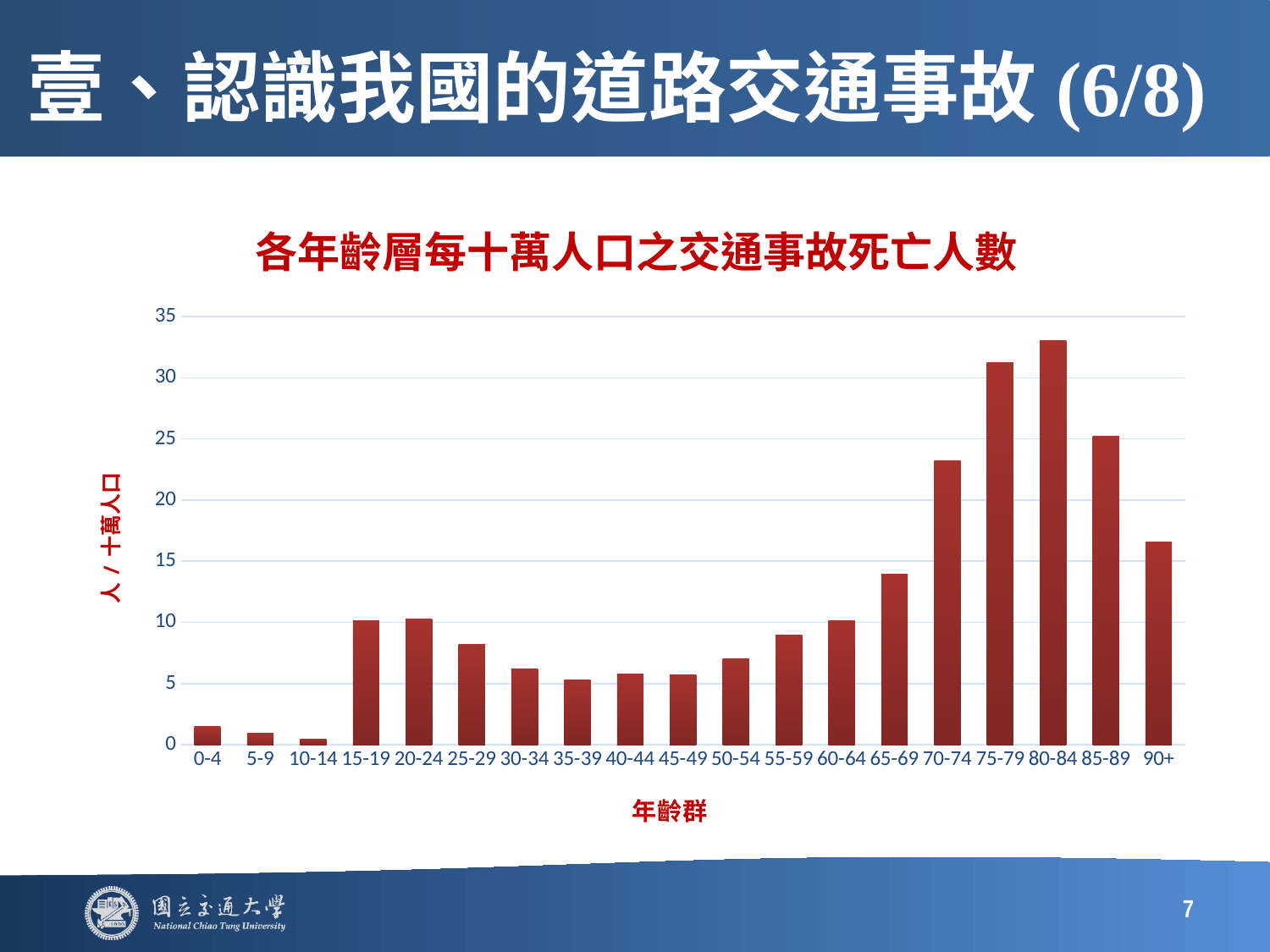
Do the values rise or fall from 35-39 to 80-84? rise What is the title of the chart? 各年齡層每十萬人口之交通事故死亡人數 Which age group has the highest value? 80-84 Which age group has the lowest value? 10-14 What is the label of the x axis? 年齡群 What kind of chart is shown on the slide? bar chart Is the value for 70-74 greater or less than 20? greater Which is larger, the value for 80-84 or the value for 75-79? 80-84 Is the value for 35-39 greater or less than 10? less Is the value for 90+ greater or less than 15? greater How many age groups are shown on the x axis? 19